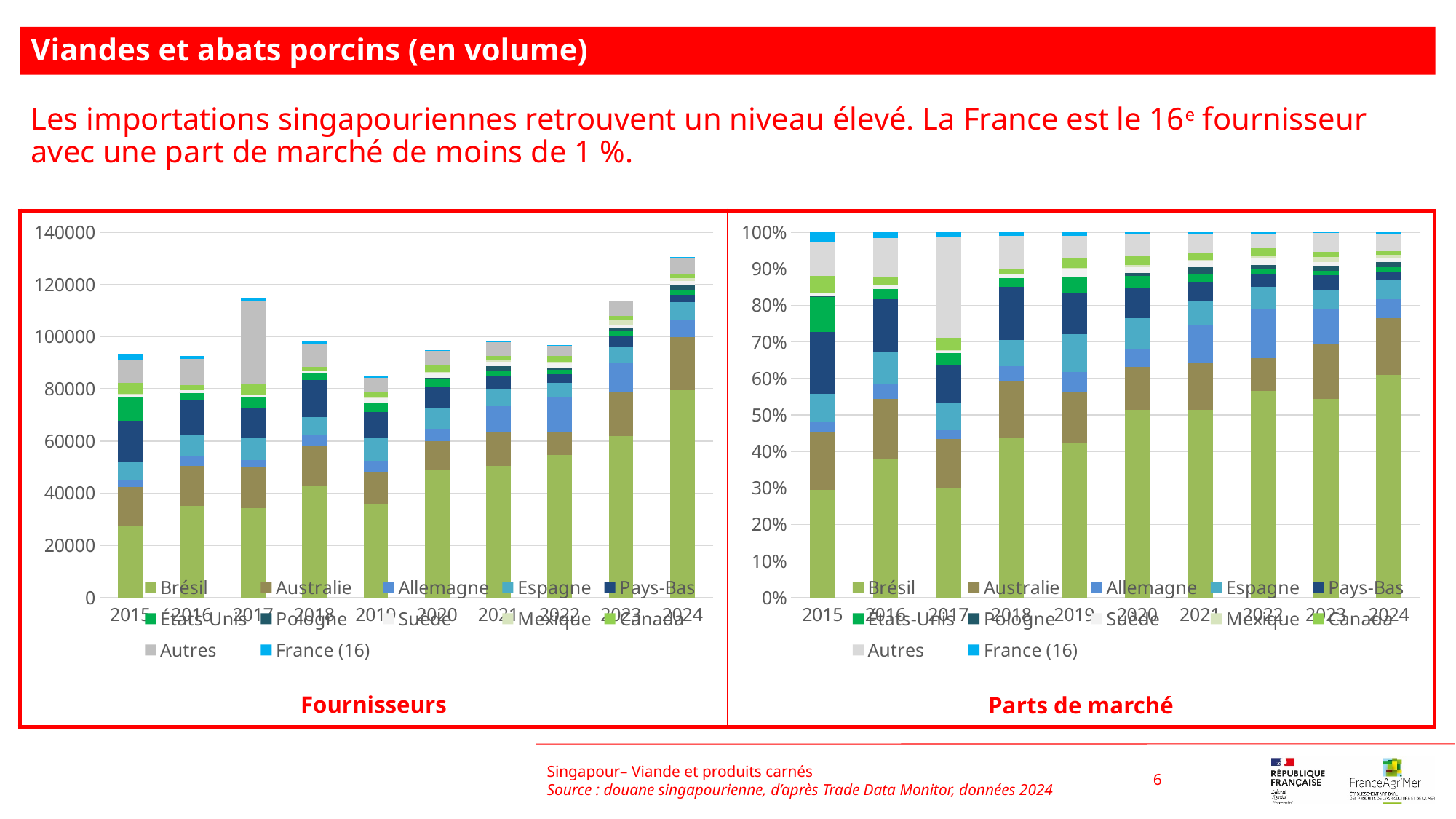
How many series does the legend of the 'Parts de marché' chart list? 12 In the 'Parts de marché' chart, in which year is the share of Brésil the highest? 2024 In the 'Fournisseurs' chart, do the total bars rise or fall from 2019 to 2024? rise In the 'Fournisseurs' chart, which year has the lowest total bar? 2019 In the 'Fournisseurs' chart, which year has the highest total bar? 2024 Which series is listed last in the legend of the 'Fournisseurs' chart? France (16) In the 'Fournisseurs' chart, is the total for 2019 greater or less than 100000? less In the 'Fournisseurs' chart, is the total for 2024 greater or less than 120000? greater How many years are shown on the x axis of the 'Fournisseurs' chart? 10 What kind of chart is the 'Fournisseurs' chart on the left? stacked bar chart In the 'Fournisseurs' chart, which total is larger, 2023 or 2022? 2023